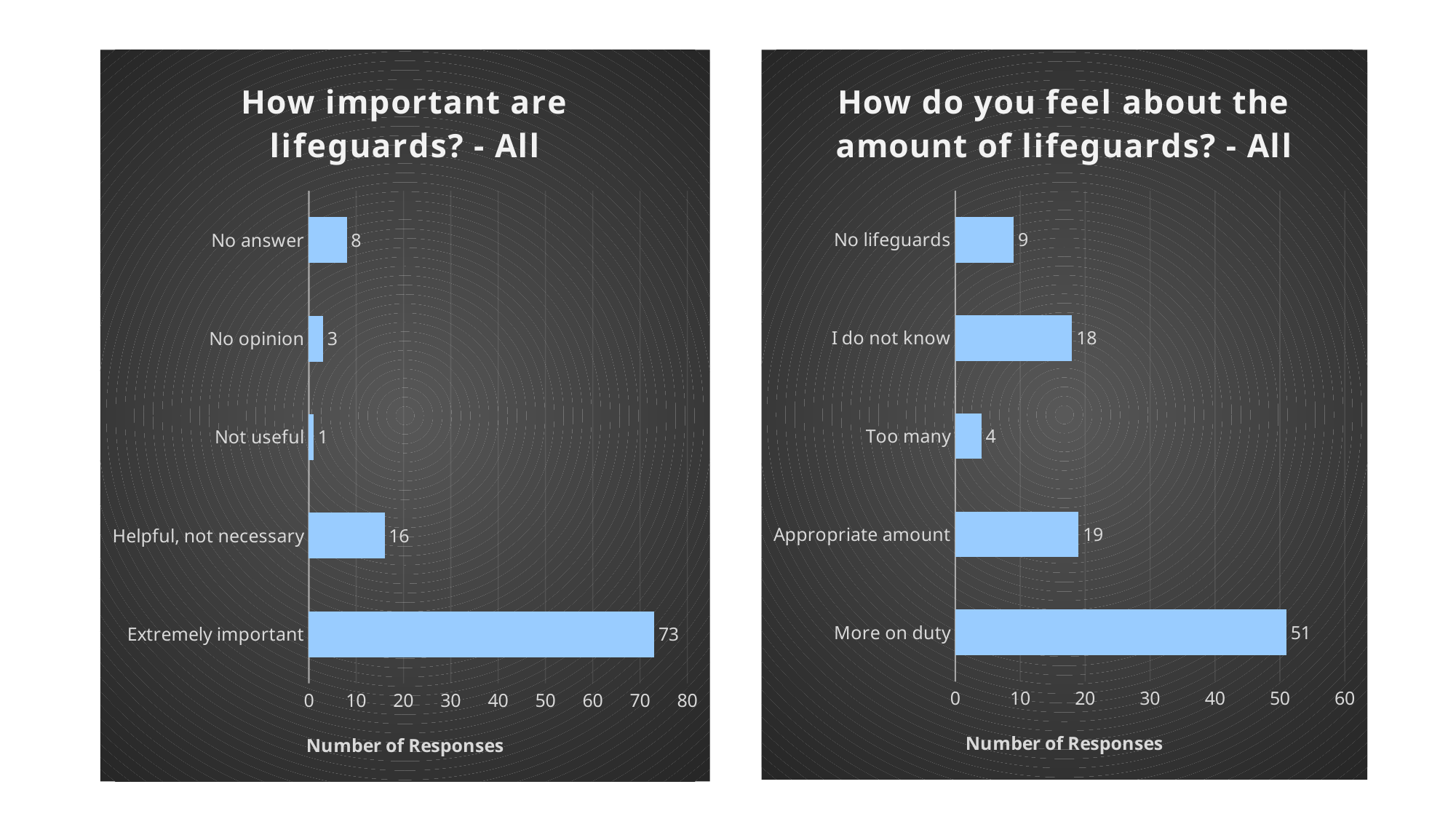
In the chart titled "How important are lifeguards? - All", how many responses were for "Extremely important"? 73 In the chart titled "How do you feel about the amount of lifeguards? - All", what is the difference in responses between "Appropriate amount" and "Too many"? 15 What is the x-axis label on the chart titled "How important are lifeguards? - All"? Number of Responses In the chart titled "How important are lifeguards? - All", how many responses were for "Helpful, not necessary"? 16 In the chart titled "How important are lifeguards? - All", what is the difference in responses between "Extremely important" and "Helpful, not necessary"? 57 In the chart titled "How important are lifeguards? - All", how many categories are shown? 5 What type of chart is the chart titled "How do you feel about the amount of lifeguards? - All"? Bar chart In the chart titled "How do you feel about the amount of lifeguards? - All", how many responses were for "More on duty"? 51 In the chart titled "How important are lifeguards? - All", which category has the lowest number of responses? Not useful In the chart titled "How do you feel about the amount of lifeguards? - All", which has more responses, "No lifeguards" or "Too many"? No lifeguards In the chart titled "How do you feel about the amount of lifeguards? - All", which category has the highest number of responses? More on duty In the chart titled "How do you feel about the amount of lifeguards? - All", how many responses were for "I do not know"? 18